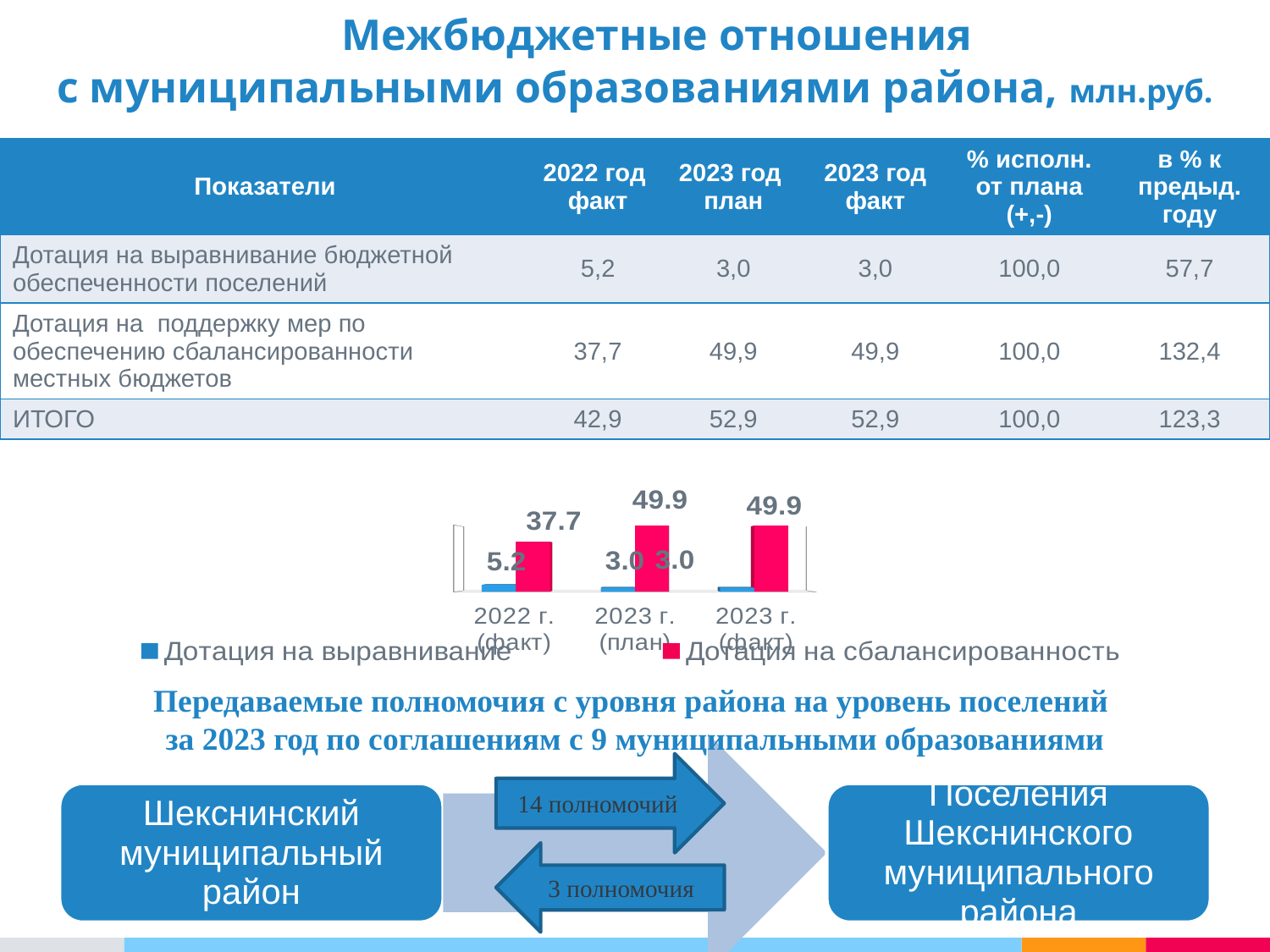
What is the value of Дотация на сбалансированность for 2022 г. (факт) in the chart? 37.7 What kind of chart is shown on the slide? bar chart Does Дотация на сбалансированность rise or fall from 2022 г. (факт) to 2023 г. (план)? rise What is the value of Дотация на выравнивание for 2022 г. (факт) in the chart? 5.2 How many series does the chart legend list? 2 In which category is Дотация на выравнивание highest? 2022 г. (факт) What is the value of Дотация на сбалансированность for 2023 г. (план) in the chart? 49.9 For 2022 г. (факт), which series has the larger value: Дотация на выравнивание or Дотация на сбалансированность? Дотация на сбалансированность How many categories are shown on the x axis of the chart? 3 What is the value of Дотация на выравнивание for 2023 г. (план) in the chart? 3.0 What is the difference between Дотация на сбалансированность and Дотация на выравнивание for 2022 г. (факт)? 32.5 In which category is Дотация на сбалансированность lowest? 2022 г. (факт)